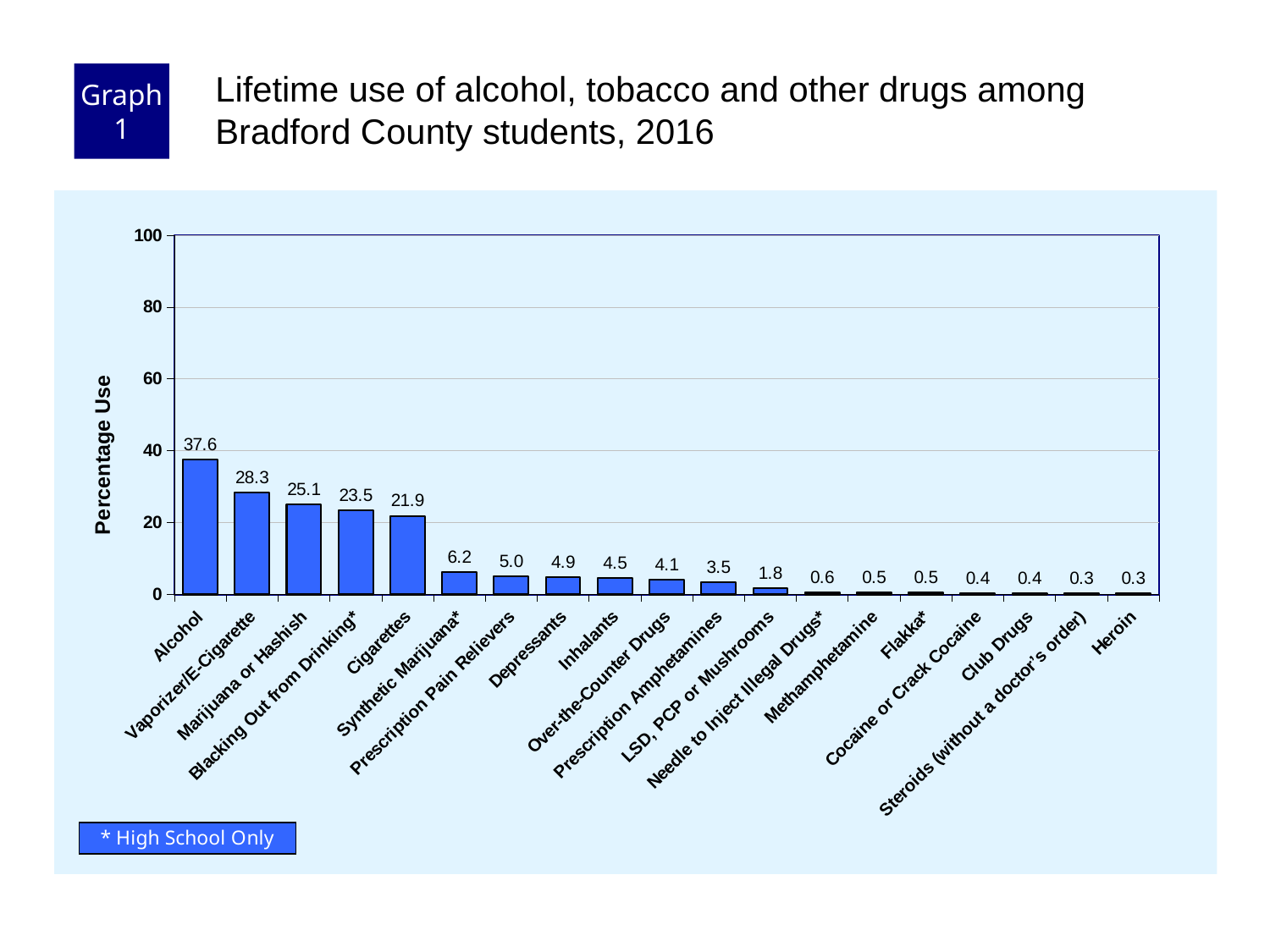
Which has a higher percentage use, Inhalants or Over-the-Counter Drugs? Inhalants How many categories are shown on the x axis of the chart? 19 What is the percentage use value for Heroin? 0.3 Which category has the highest percentage use? Alcohol What is the percentage use value for Synthetic Marijuana*? 6.2 What is the difference in percentage use between Marijuana or Hashish and Cigarettes? 3.2 What is the percentage use value for Cigarettes? 21.9 What is the percentage use value for Alcohol? 37.6 What is the difference in percentage use between Alcohol and Vaporizer/E-Cigarette? 9.3 What is the percentage use value for LSD, PCP or Mushrooms? 1.8 Is the value for Blacking Out from Drinking* greater or less than 20? greater What kind of chart is shown on the slide? Bar chart